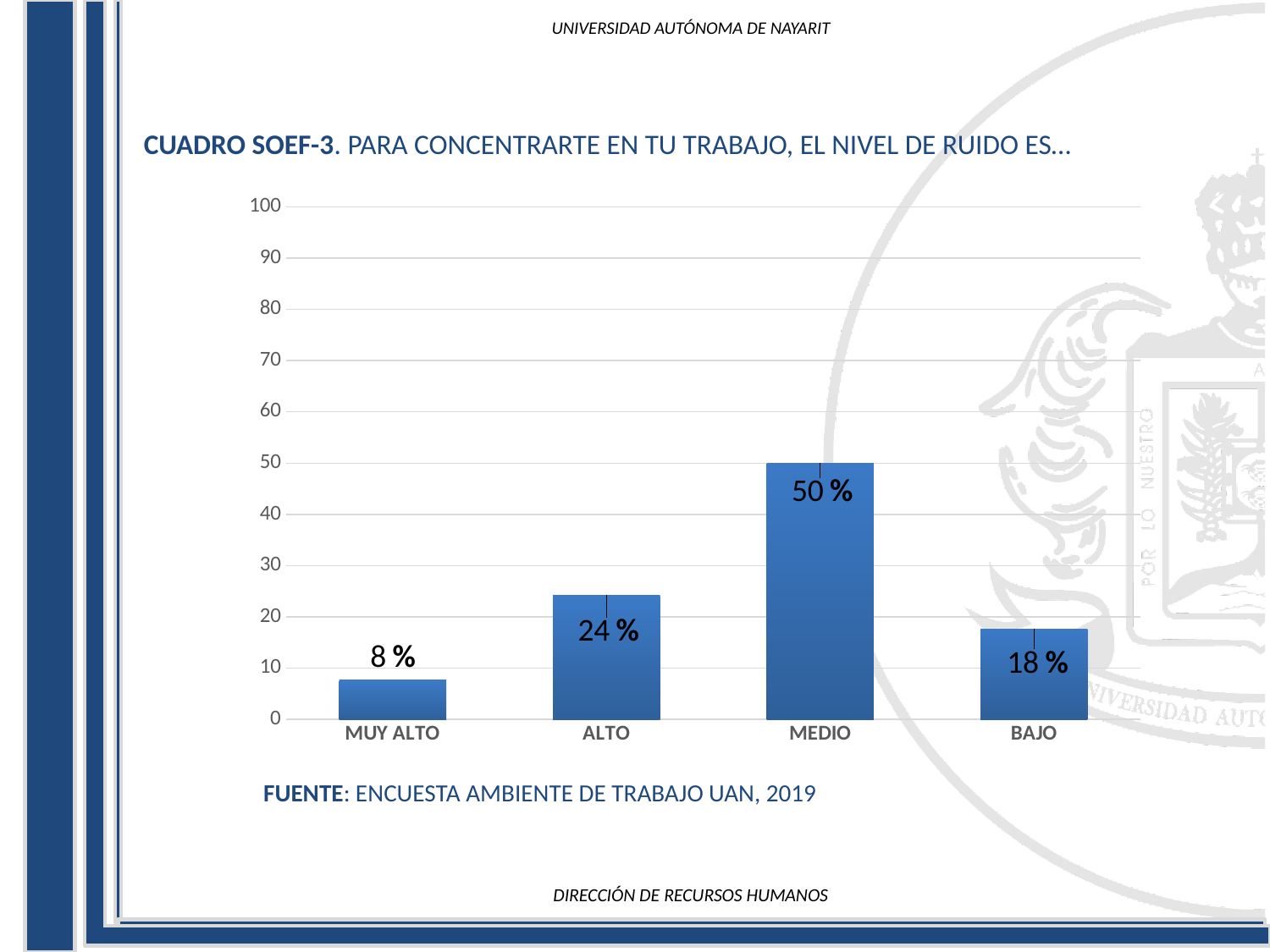
Which is larger, the value for ALTO or the value for BAJO? ALTO What is the value for BAJO? 18 % What is the value for MUY ALTO? 8 % What kind of chart is shown on the slide? bar chart What is the difference between the values for MEDIO and ALTO? 26 % Which category has the highest value? MEDIO Is the value for MEDIO greater or less than 40? greater How many categories are shown on the x axis? 4 What is the value for ALTO? 24 % What is the value for MEDIO? 50 % What is the source cited below the chart? ENCUESTA AMBIENTE DE TRABAJO UAN, 2019 Which category has the lowest value? MUY ALTO